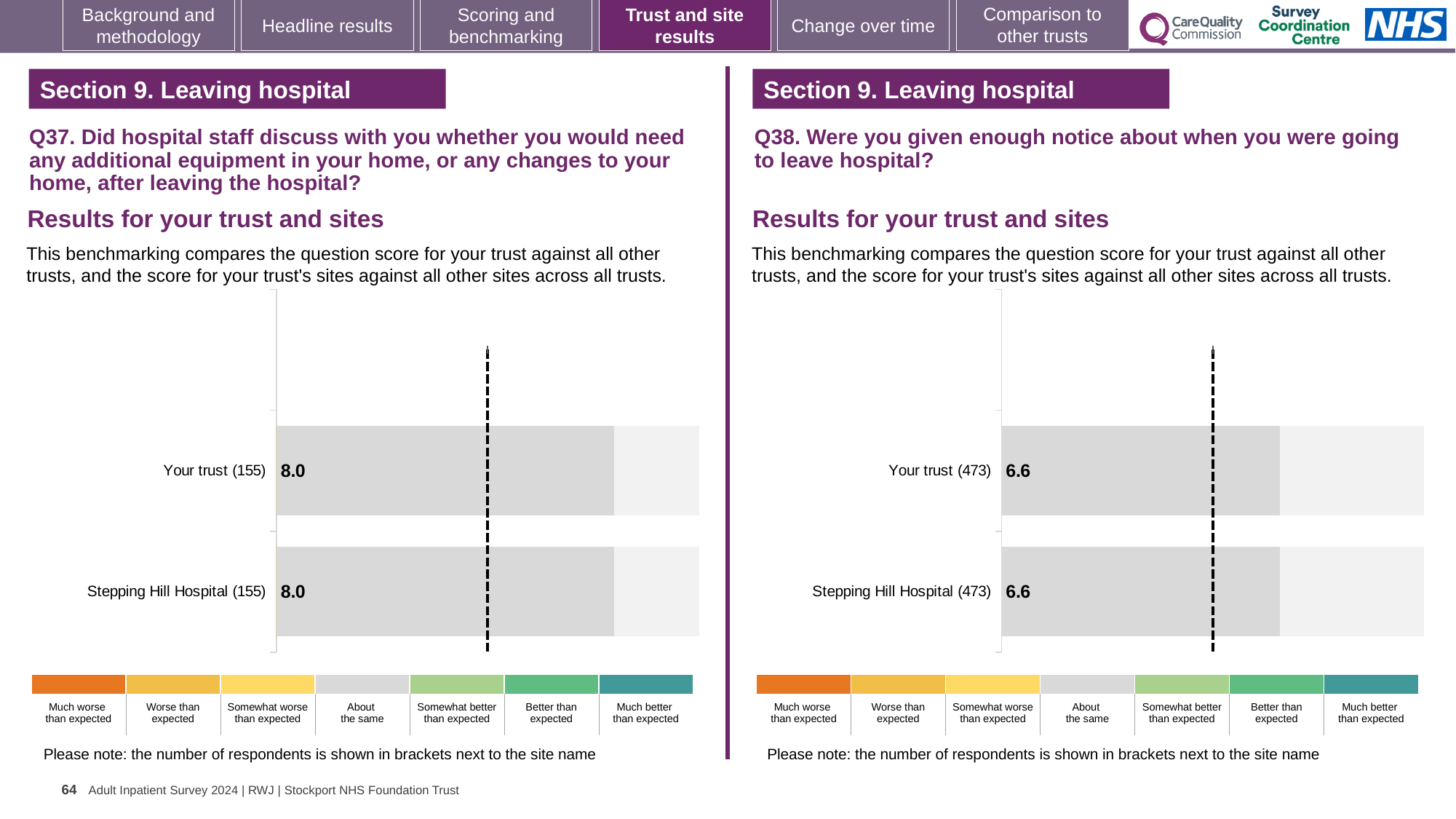
In the Q38 chart on the right, what is the score for Stepping Hill Hospital? 6.6 In the Q38 chart on the right, how many respondents are shown in brackets for Your trust? 473 In the Q38 chart on the right, which benchmark category does the Your trust bar fall into according to the colour key? About the same What type of chart is used for the Q37 results on the left? Bar chart Is the Your trust score in the Q37 chart on the left larger than the Your trust score in the Q38 chart on the right? Yes In the Q37 chart on the left, what is the score for Your trust? 8.0 In the Q37 chart on the left, what is the score for Stepping Hill Hospital? 8.0 How many categories are listed in the colour key below the Q37 chart on the left? 7 In the Q37 chart on the left, what is the difference between the score for Your trust and the score for Stepping Hill Hospital? 0.0 In the Q38 chart on the right, what is the score for Your trust? 6.6 In the Q37 chart on the left, how many respondents are shown in brackets for Stepping Hill Hospital? 155 In the Q38 chart on the right, how many bars are plotted? 2